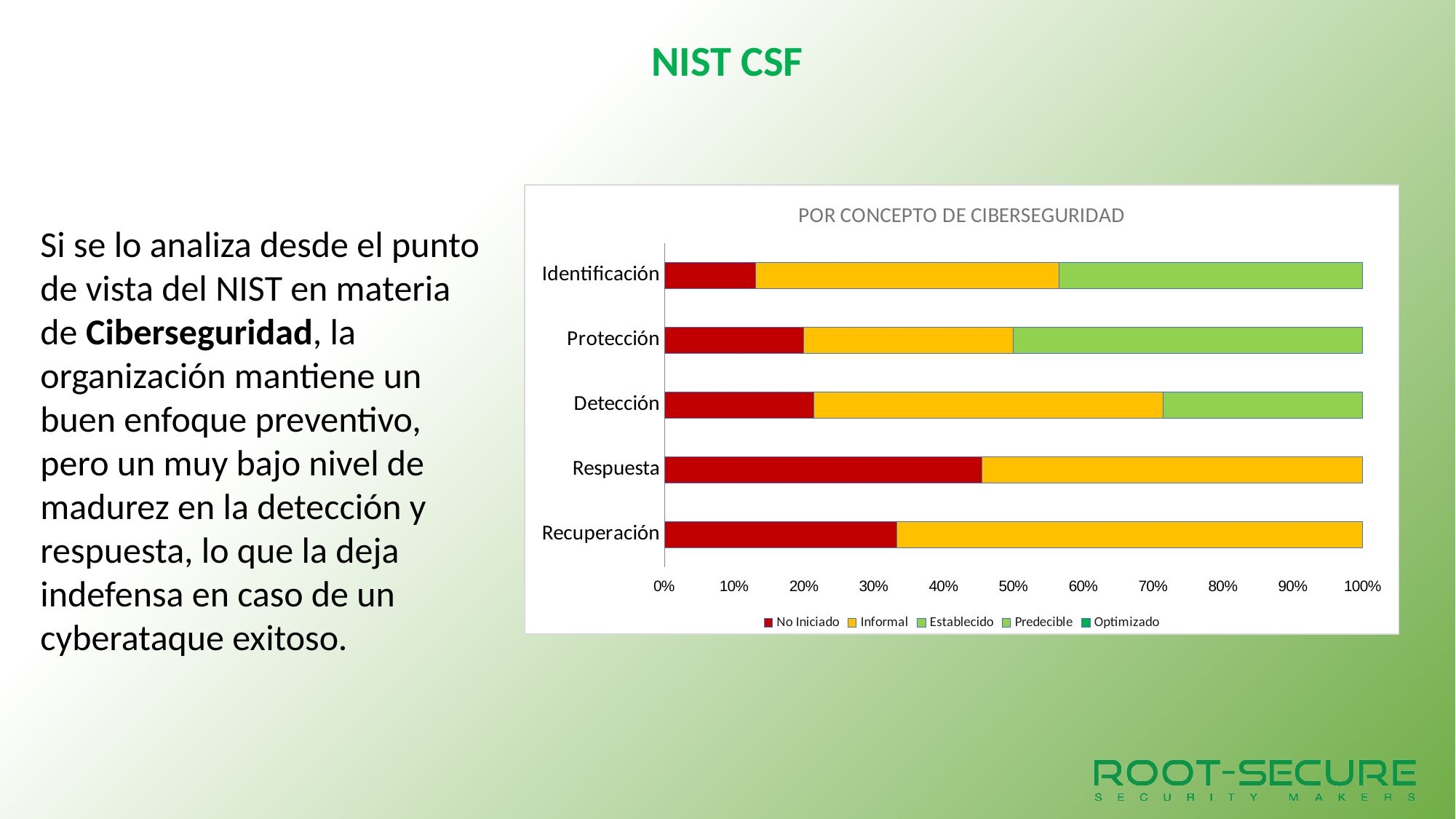
How many categories are plotted on the chart? 5 How many series does the chart legend list? 5 Which has a larger No Iniciado segment, Respuesta or Recuperación? Respuesta What is the title of the chart? POR CONCEPTO DE CIBERSEGURIDAD Which category has the largest Establecido segment? Protección Which categories have no Establecido segment in their bar? Respuesta and Recuperación Which category has the smallest No Iniciado segment? Identificación Which category has the largest No Iniciado segment? Respuesta Is the No Iniciado value for Respuesta greater or less than 40%? greater Is the No Iniciado value for Recuperación greater or less than 30%? greater Is the No Iniciado value for Identificación greater or less than 20%? less What kind of chart is shown on the slide? Bar chart